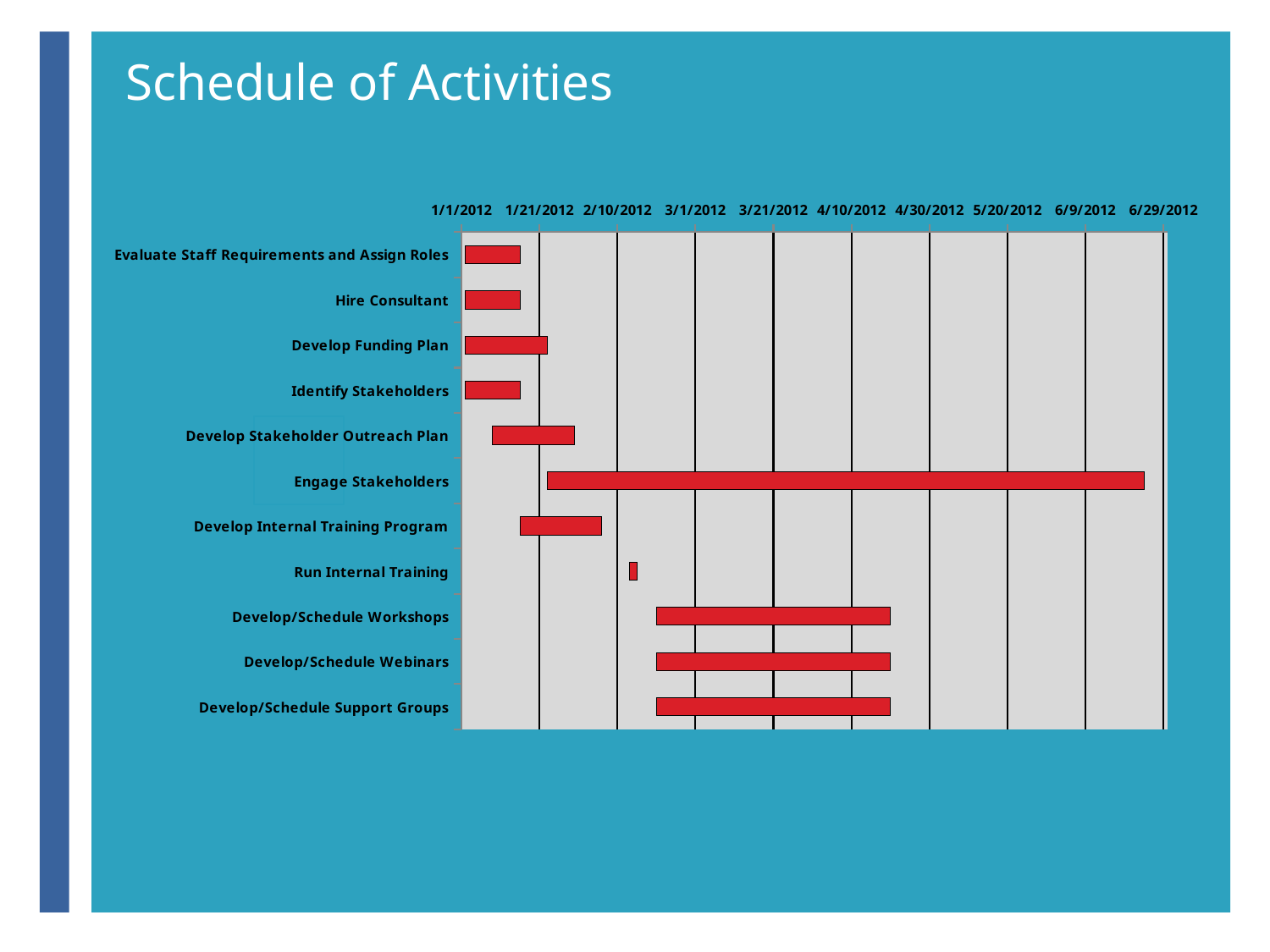
Which activity has the longest bar on the chart? Engage Stakeholders Does the Engage Stakeholders bar extend past the 6/9/2012 gridline? yes Which bar is longer, Develop Funding Plan or Hire Consultant? Develop Funding Plan What is the first date label on the horizontal axis? 1/1/2012 How many activities have bars that start after 3/1/2012? 0 What is the title of the slide containing the chart? Schedule of Activities Does the Develop/Schedule Workshops bar start before or after 3/1/2012? before Which bar is longer, Develop Internal Training Program or Develop Stakeholder Outreach Plan? Neither; they are the same length How many activities are listed on the chart? 11 What kind of chart is shown on the slide? bar chart Which activity has the shortest bar on the chart? Run Internal Training Which activity is listed first (at the top) on the chart? Evaluate Staff Requirements and Assign Roles